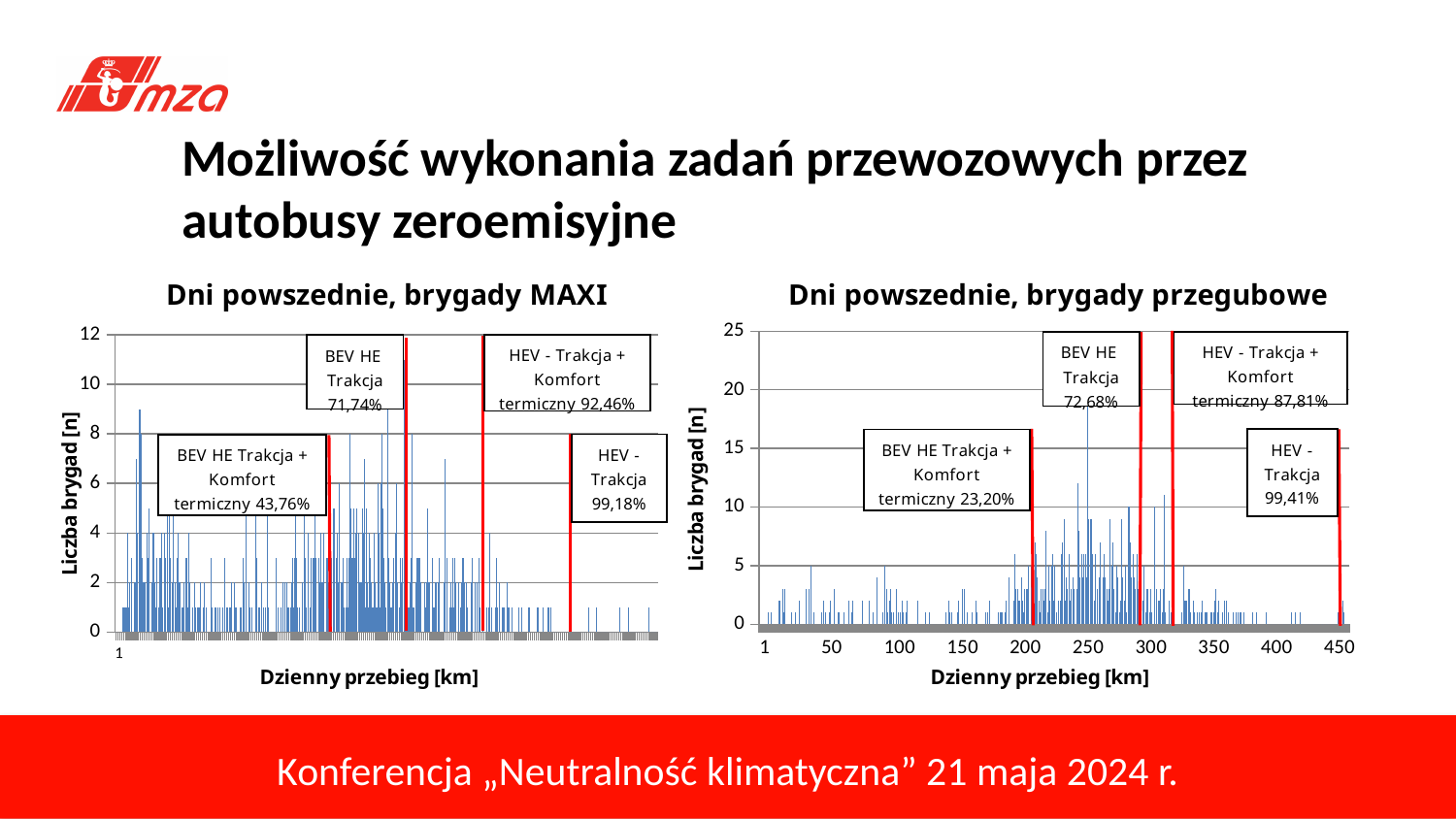
In the chart "Dni powszednie, brygady MAXI", what percentage is shown for "BEV HE Trakcja"? 71,74% In the chart "Dni powszednie, brygady MAXI", what percentage is shown for "HEV - Trakcja"? 99,18% What is the x-axis label of the chart "Dni powszednie, brygady przegubowe"? Dzienny przebieg [km] What is the title of the chart on the right side of the slide? Dni powszednie, brygady przegubowe In the chart "Dni powszednie, brygady MAXI", what percentage is shown for "HEV - Trakcja + Komfort termiczny"? 92,46% In the chart "Dni powszednie, brygady przegubowe", what percentage is shown for "BEV HE Trakcja + Komfort termiczny"? 23,20% In the chart "Dni powszednie, brygady przegubowe", what percentage is shown for "HEV - Trakcja"? 99,41% In the chart "Dni powszednie, brygady przegubowe", what percentage is shown for "BEV HE Trakcja"? 72,68% In the chart "Dni powszednie, brygady przegubowe", is the tallest bar greater or less than 15? greater What kind of chart is "Dni powszednie, brygady MAXI"? Bar chart In the chart "Dni powszednie, brygady MAXI", what percentage is shown for "BEV HE Trakcja + Komfort termiczny"? 43,76% Which chart shows the higher percentage for "HEV - Trakcja": "Dni powszednie, brygady MAXI" or "Dni powszednie, brygady przegubowe"? Dni powszednie, brygady przegubowe